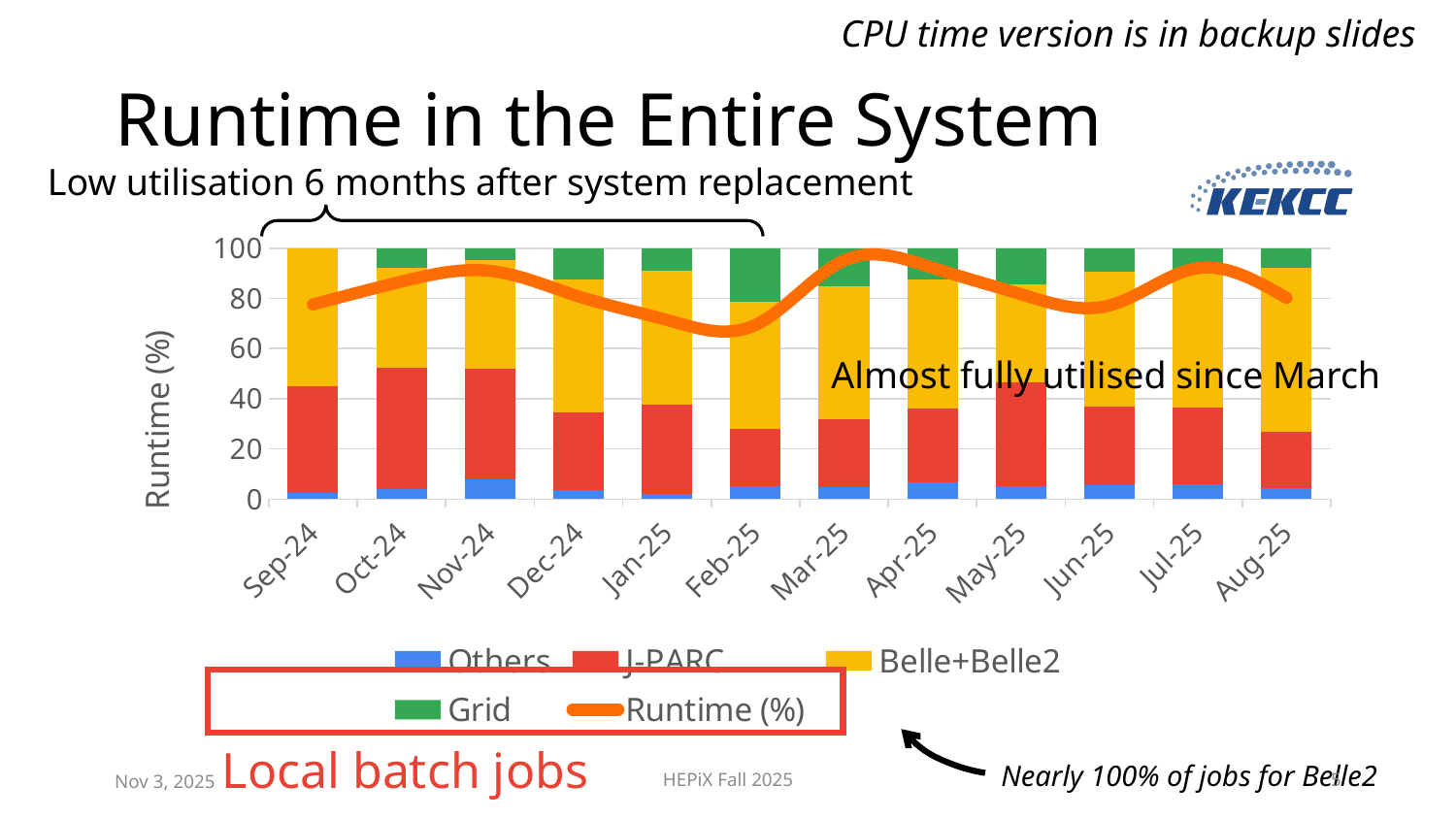
Which month has the larger J-PARC segment, Nov-24 or Aug-25? Nov-24 Is the Runtime (%) line value for Feb-25 greater or less than 80? less What type of chart is shown on the slide? Stacked bar chart with a line overlay How many months are shown on the x axis of the chart? 12 Is the Runtime (%) line value for Mar-25 greater or less than 80? greater How many series does the chart legend list? 5 Which month has the lowest value on the Runtime (%) line? Feb-25 Which month has the larger Belle+Belle2 segment, Sep-24 or Nov-24? Sep-24 What is the label of the y axis? Runtime (%) Which month has the highest value on the Runtime (%) line? Mar-25 Does the Runtime (%) line rise or fall from Nov-24 to Feb-25? fall